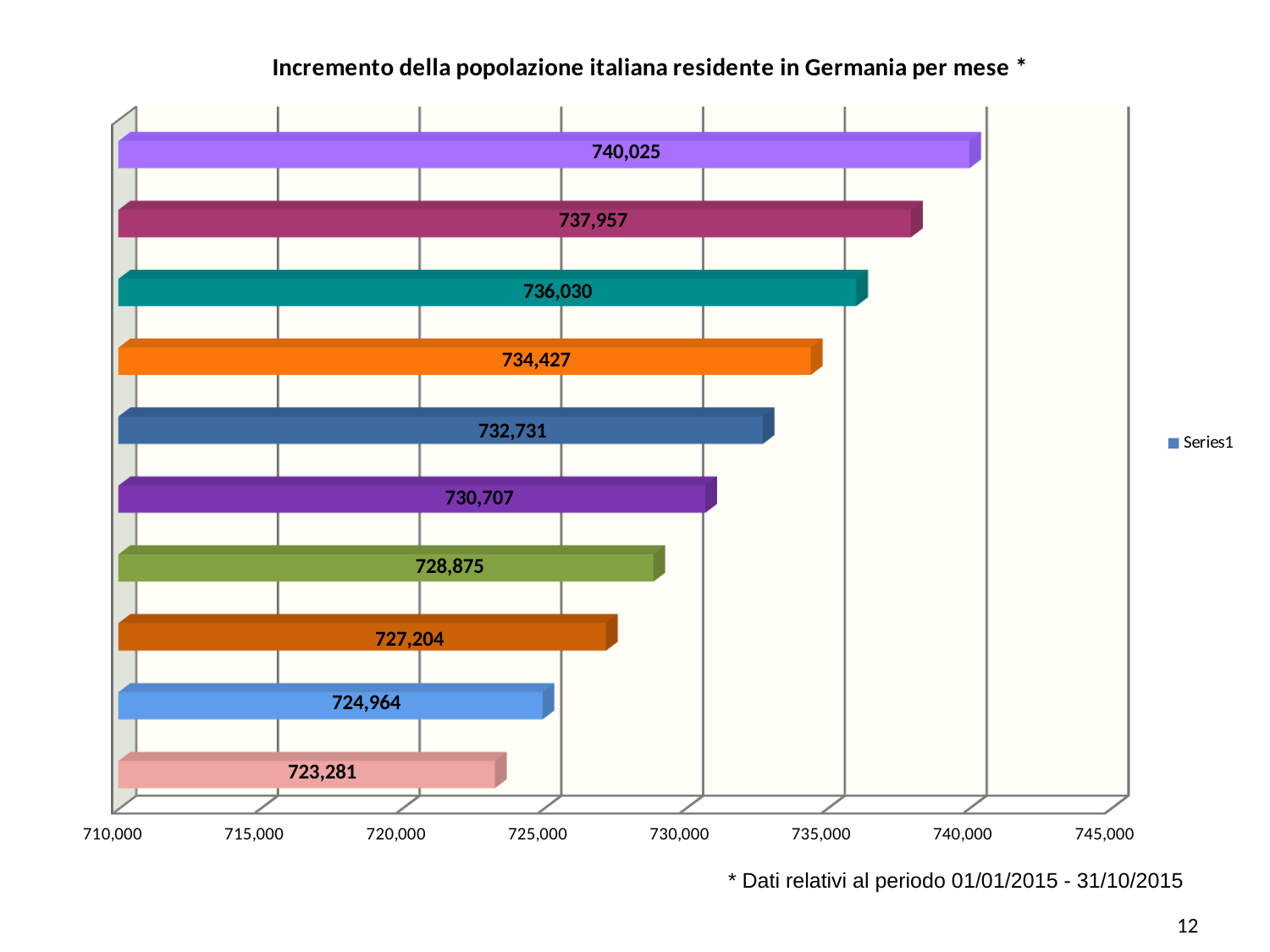
How many series does the legend list? 1 What is the title of the chart? Incremento della popolazione italiana residente in Germania per mese * How many bars are plotted in the chart? 10 Which is larger, the value of the second bar from the top or the value of the third bar from the top? the second bar from the top (737,957) What is the value shown on the bottom bar of the chart? 723,281 What is the highest value shown in the chart? 740,025 What is the value shown on the fifth bar from the top? 732,731 What is the value shown on the topmost bar of the chart? 740,025 What is the difference between the topmost bar's value and the bottom bar's value? 16,744 Do the bar values increase or decrease going from the top bar to the bottom bar? decrease What is the lowest value shown in the chart? 723,281 What kind of chart is shown on the slide? bar chart